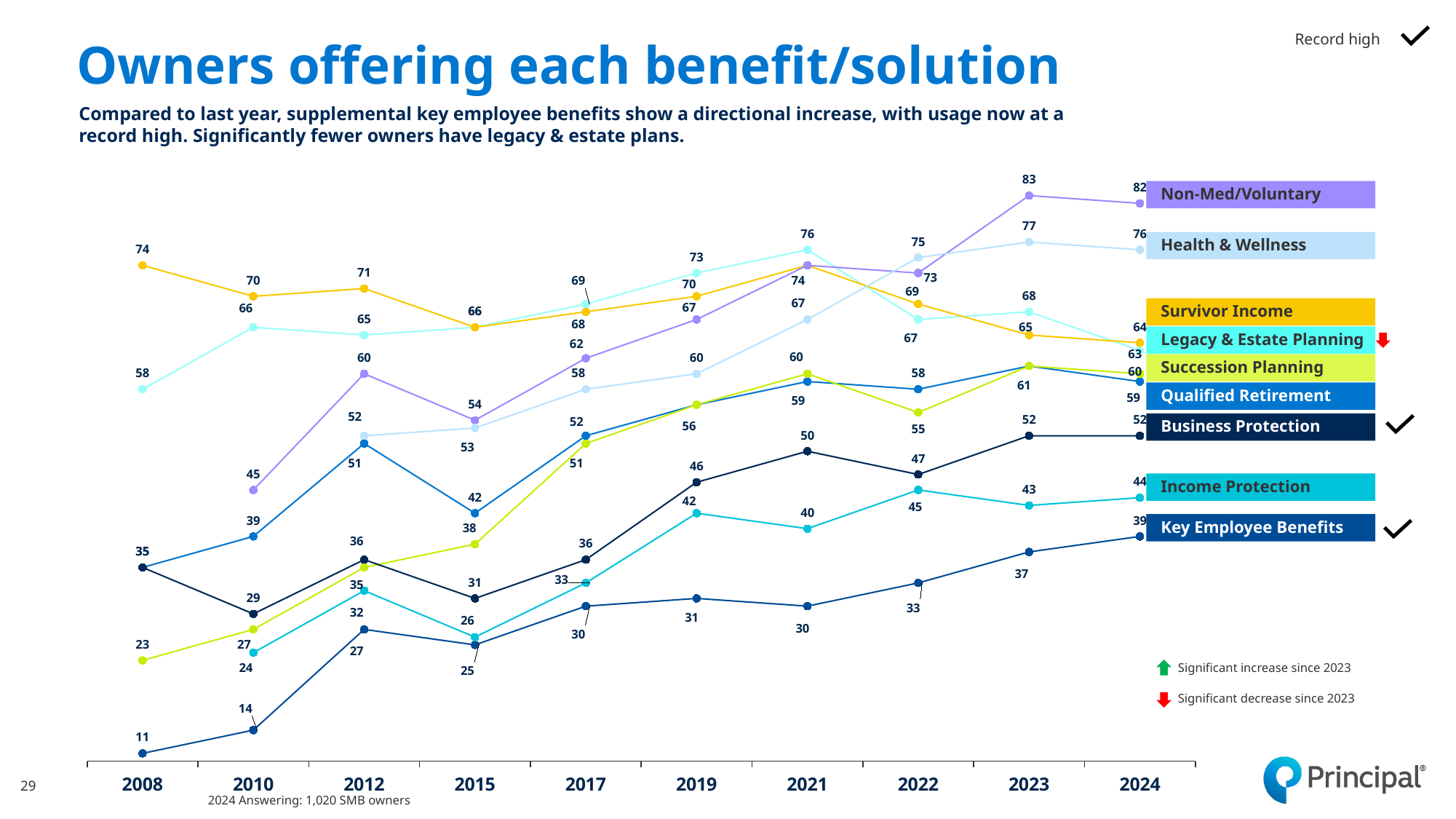
Which series has the highest value in 2024? Non-Med/Voluntary How many series (benefit/solution lines) does the chart show? 9 How many years are shown on the x axis of the chart? 10 By how much did Non-Med/Voluntary change from 2023 to 2024? 1 What is the value for Survivor Income in 2008? 74 What is the value for Non-Med/Voluntary in 2024? 82 Which series is marked with a red arrow indicating a significant decrease since 2023? Legacy & Estate Planning Does the Key Employee Benefits line rise or fall from 2008 to 2024? rise What is the value for Key Employee Benefits in 2008? 11 Which series has the lowest value in 2024? Key Employee Benefits Which is larger in 2024, Health & Wellness or Survivor Income? Health & Wellness What kind of chart is shown on the slide? line chart